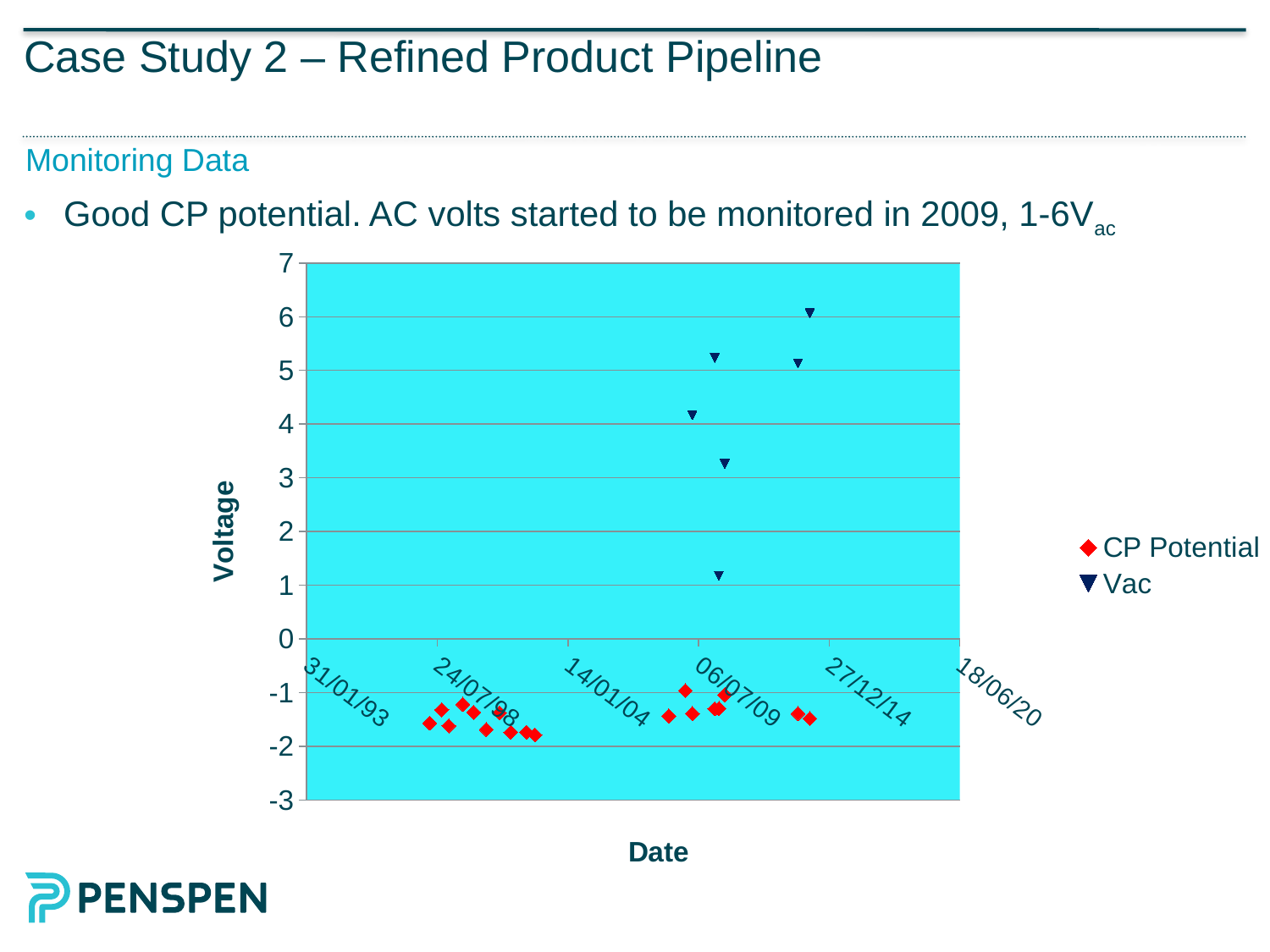
How many Vac data points are plotted on the chart? 6 What are the two series named in the chart legend? CP Potential and Vac Is the highest Vac value greater or less than 5? greater Which series has the higher plotted values, CP Potential or Vac? Vac How many series does the chart legend list? 2 Are the CP Potential values greater or less than -3? greater Is the lowest Vac value greater or less than 2? less What kind of chart is shown on the slide? Scatter chart Which series contains the highest plotted value on the chart? Vac What is the title of the chart's vertical axis? Voltage Which series has the lowest plotted value on the chart? CP Potential